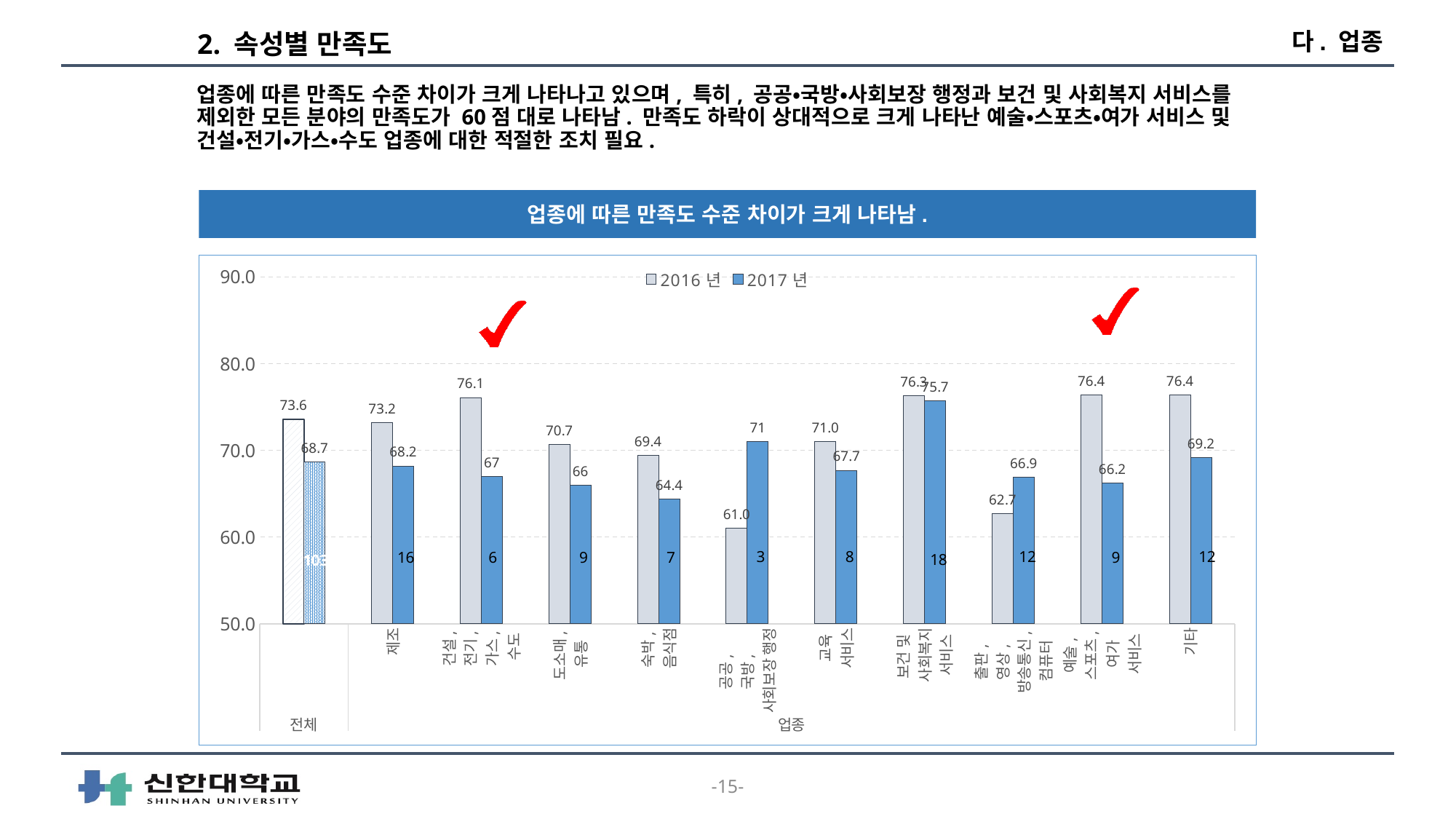
Which category has the highest 2017 년 value? 보건 및 사회복지 서비스 What is the difference between the 2016 년 and 2017 년 values for 예술, 스포츠, 여가 서비스? 10.2 What is the 2016 년 value for 건설, 전기, 가스, 수도? 76.1 What is the 2017 년 value for 공공, 국방, 사회보장 행정? 71 What is the difference between the 2016 년 and 2017 년 values for 건설, 전기, 가스, 수도? 9.1 Which category has the lowest 2016 년 value? 공공, 국방, 사회보장 행정 What is the 2016 년 value for 전체? 73.6 How many series does the legend list? 2 What kind of chart is shown on the slide? Bar chart For 출판, 영상, 방송통신, 컴퓨터, which is larger: the 2016 년 value or the 2017 년 value? 2017 년 Which category has the lowest 2017 년 value? 숙박, 음식점 What is the 2017 년 value for 제조? 68.2